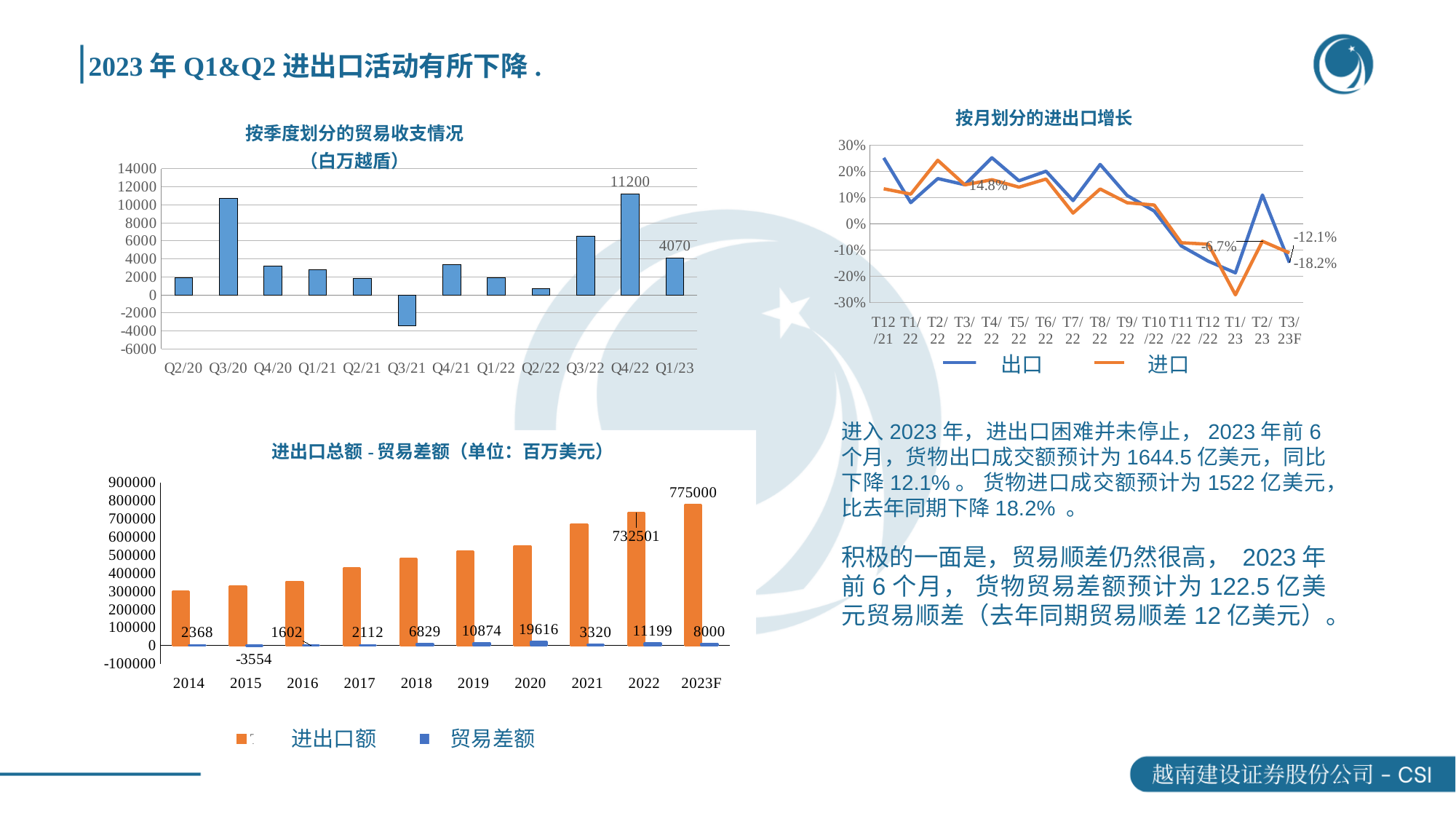
In the chart titled 按季度划分的贸易收支情况, what is the value for Q4/22? 11200 In the chart titled 按季度划分的贸易收支情况, which quarter has the highest value? Q4/22 In the chart titled 按季度划分的贸易收支情况, which quarter has the lowest value? Q3/21 In the chart titled 进出口总额 - 贸易差额, what is the 进出口额 value for 2023F? 775000 How many quarters are shown on the x axis of the chart titled 按季度划分的贸易收支情况? 12 In the chart titled 按季度划分的贸易收支情况, what is the difference between the Q4/22 and Q1/23 values? 7130 In the chart titled 进出口总额 - 贸易差额, how many series does the legend list? 2 What kind of chart is the one titled 按月划分的进出口增长? line chart In the chart titled 按季度划分的贸易收支情况, what is the value for Q1/23? 4070 In the chart titled 进出口总额 - 贸易差额, what is the 贸易差额 value for 2015? -3554 In the chart titled 按季度划分的贸易收支情况, is the value for Q3/20 greater or less than 8000? greater